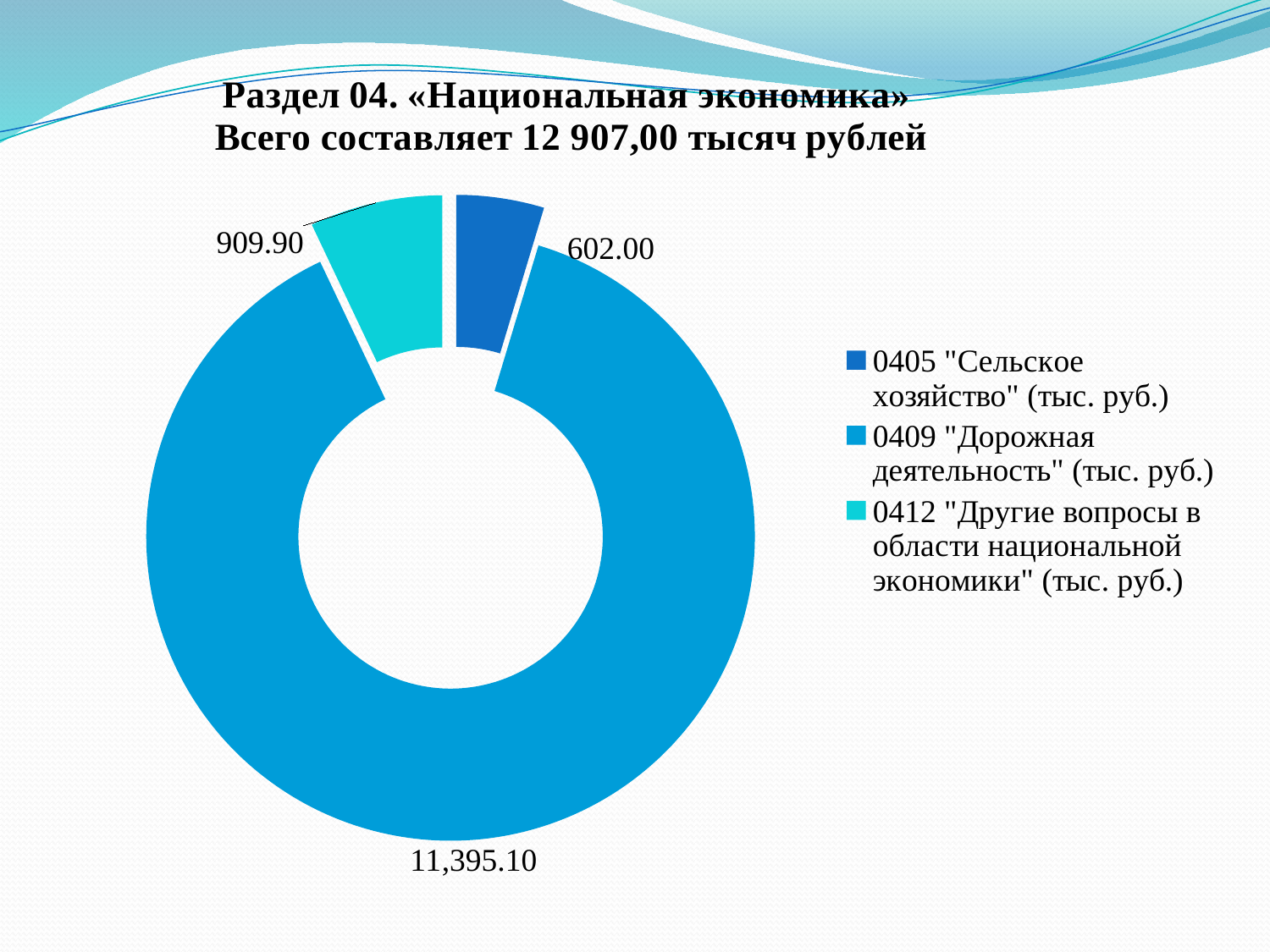
Which category has the largest slice? 0409 "Дорожная деятельность" (тыс. руб.) How many categories does the chart show? 3 What is the difference between the values for 0412 "Другие вопросы в области национальной экономики" and 0405 "Сельское хозяйство"? 307.90 What is the value for 0405 "Сельское хозяйство" (тыс. руб.)? 602.00 What colour is the slice for 0412 "Другие вопросы в области национальной экономики"? Turquoise (light teal) What is the value for 0409 "Дорожная деятельность" (тыс. руб.)? 11,395.10 What is the difference between the values for 0409 "Дорожная деятельность" and 0412 "Другие вопросы в области национальной экономики"? 10,485.20 What kind of chart is shown on the slide? Doughnut (pie) chart What is the value for 0412 "Другие вопросы в области национальной экономики" (тыс. руб.)? 909.90 What total amount does the slide title state for Раздел 04 «Национальная экономика»? 12 907,00 тысяч рублей Which category has the smallest slice? 0405 "Сельское хозяйство" (тыс. руб.) Which is larger: the value for 0405 "Сельское хозяйство" or for 0412 "Другие вопросы в области национальной экономики"? 0412 "Другие вопросы в области национальной экономики"